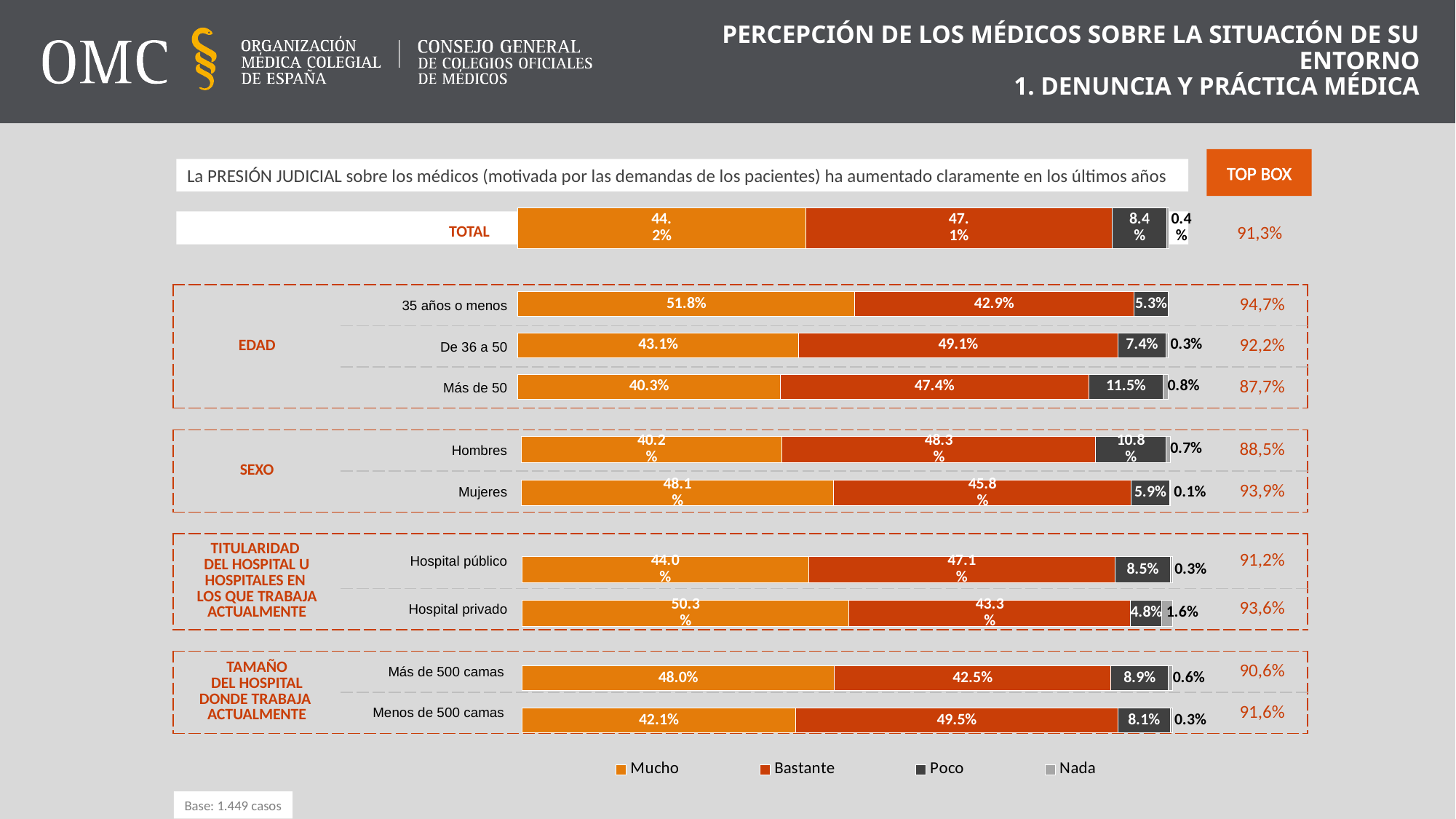
In the EDAD chart, which age group has the highest Poco value? Más de 50 In the TAMAÑO chart, what is the Bastante value for Menos de 500 camas? 49.5% In the TITULARIDAD chart, what is the Nada value for Hospital privado? 1.6% In the TOTAL chart, what is the value for Mucho? 44.2% How many series does the legend list? 4 In the SEXO chart, what is the Poco value for Hombres? 10.8% In the EDAD chart, what is the Bastante value for De 36 a 50? 49.1% What kind of chart is used on this slide? Stacked bar chart In the EDAD chart, which age group has the highest Mucho value? 35 años o menos In the SEXO chart, what is the difference between the Mucho values for Mujeres and Hombres? 7.9% In the TITULARIDAD chart, which is larger: the Mucho value for Hospital público or for Hospital privado? Hospital privado In the TAMAÑO chart, what is the difference between the Poco values for Más de 500 camas and Menos de 500 camas? 0.8%